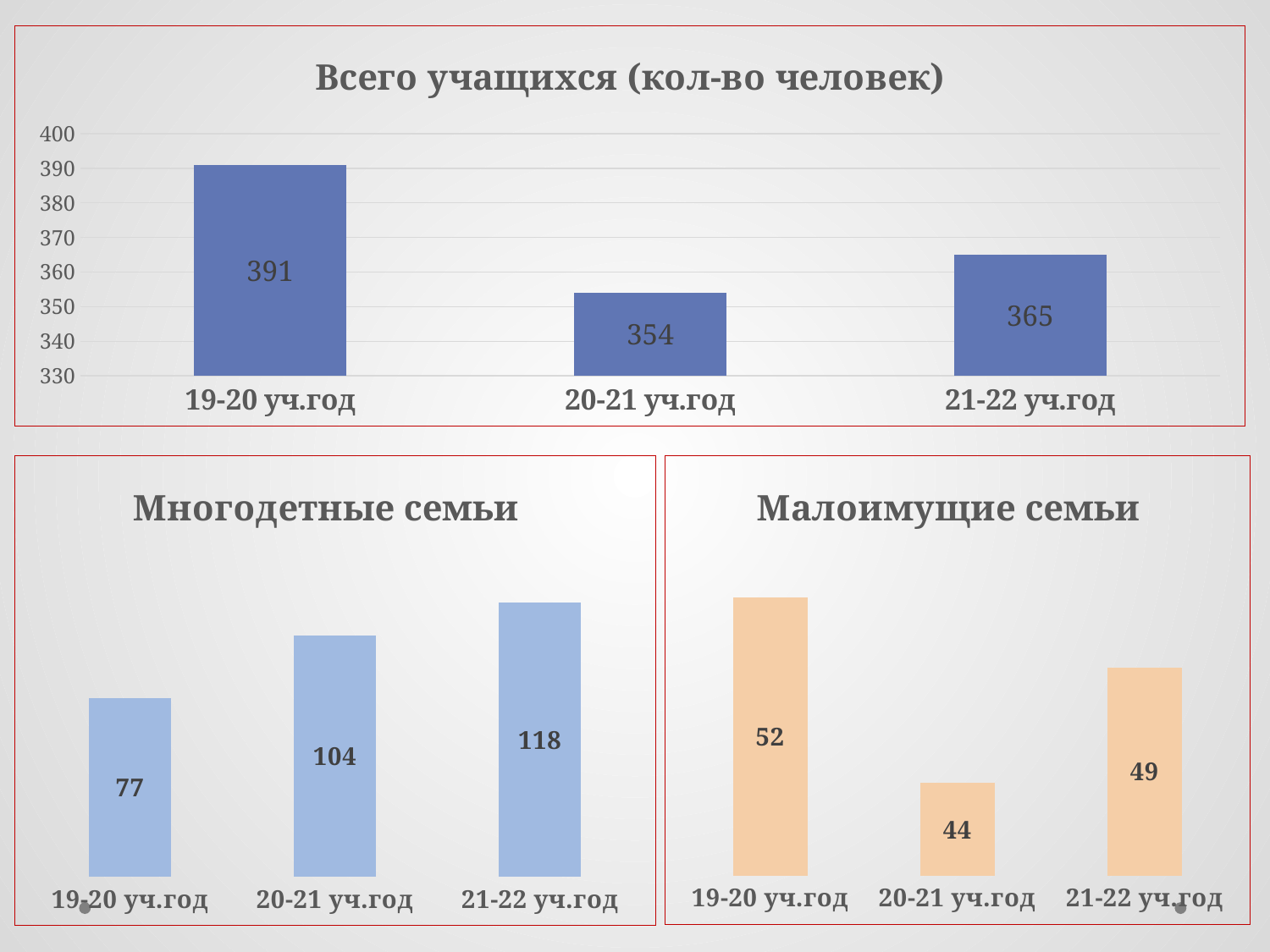
In the chart titled "Всего учащихся (кол-во человек)", what is the value for 20-21 уч.год? 354 In the chart titled "Всего учащихся (кол-во человек)", which year has the highest value? 19-20 уч.год In the chart titled "Многодетные семьи", what is the difference between the values for 20-21 уч.год and 19-20 уч.год? 27 In the chart titled "Малоимущие семьи", which is larger, the value for 19-20 уч.год or 21-22 уч.год? 19-20 уч.год In the chart titled "Всего учащихся (кол-во человек)", what is the difference between the values for 19-20 уч.год and 21-22 уч.год? 26 In the chart titled "Многодетные семьи", what is the value for 21-22 уч.год? 118 How many bars are in the chart titled "Малоимущие семьи"? 3 In the chart titled "Многодетные семьи", which year has the lowest value? 19-20 уч.год In the chart titled "Малоимущие семьи", what is the value for 20-21 уч.год? 44 In the chart titled "Многодетные семьи", do the values rise or fall from 19-20 уч.год to 21-22 уч.год? rise In the chart titled "Всего учащихся (кол-во человек)", is the value for 21-22 уч.год greater or less than 360? greater What kind of chart is the chart titled "Всего учащихся (кол-во человек)"? bar chart